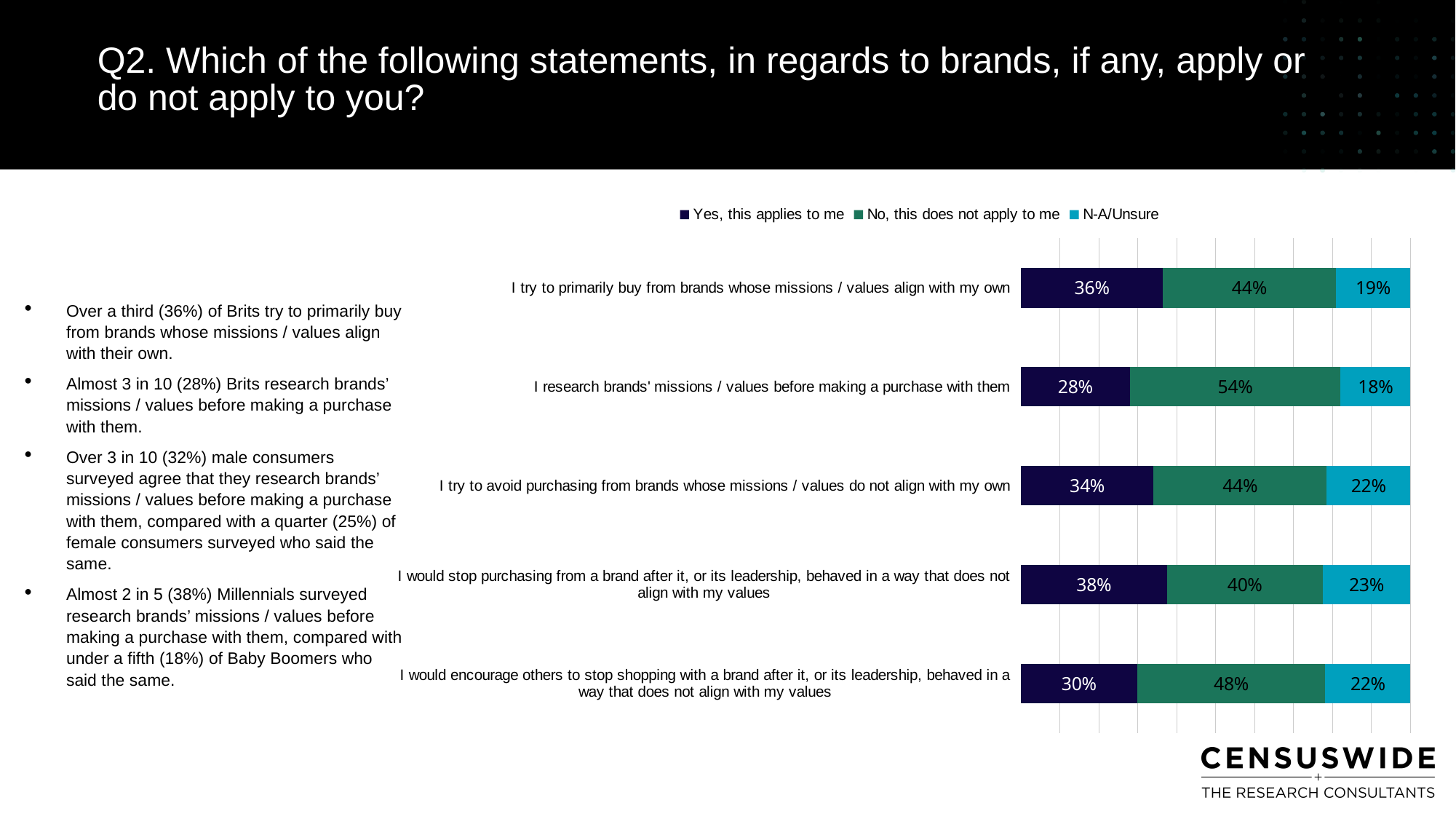
What is the difference between the "No, this does not apply to me" and "Yes, this applies to me" values for "I would encourage others to stop shopping with a brand after it, or its leadership, behaved in a way that does not align with my values"? 18% What is the N-A/Unsure value for "I would stop purchasing from a brand after it, or its leadership, behaved in a way that does not align with my values"? 23% What kind of chart is shown on the slide? Stacked bar chart Which is larger for "I try to avoid purchasing from brands whose missions / values do not align with my own": the "Yes, this applies to me" value or the "No, this does not apply to me" value? No, this does not apply to me How many series does the chart legend list? 3 Which statement has the lowest "Yes, this applies to me" value? I research brands' missions / values before making a purchase with them What percentage said "Yes, this applies to me" for "I try to primarily buy from brands whose missions / values align with my own"? 36% What percentage said "No, this does not apply to me" for "I research brands' missions / values before making a purchase with them"? 54% Which statement has the highest "No, this does not apply to me" value? I research brands' missions / values before making a purchase with them Which series is shown in the darkest (navy) colour in the chart? Yes, this applies to me How many statements (categories) are plotted in the chart? 5 Which statement has the highest "Yes, this applies to me" value? I would stop purchasing from a brand after it, or its leadership, behaved in a way that does not align with my values